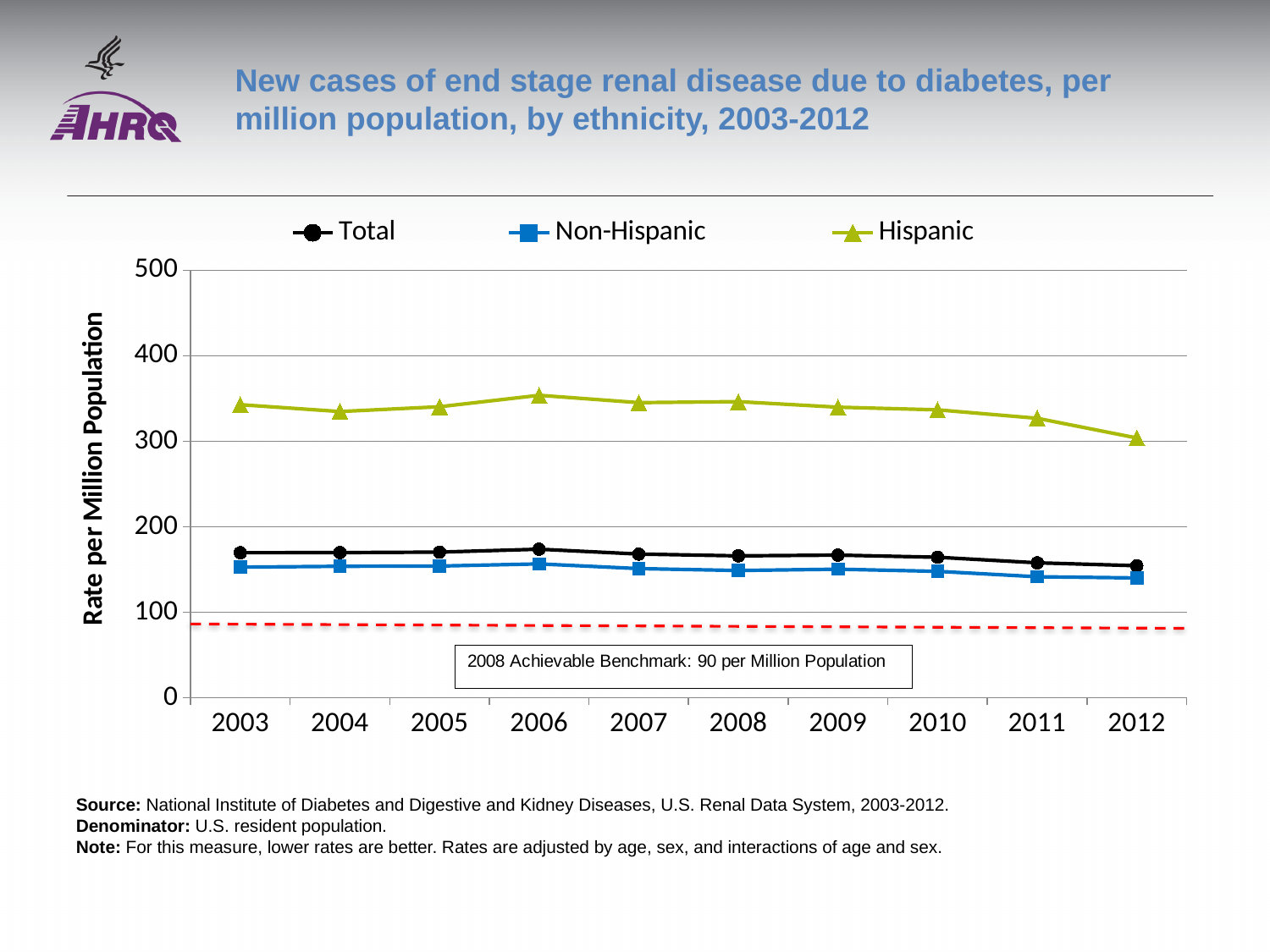
How many years are plotted along the x axis? 10 How many series does the legend list? 3 Is the value for Hispanic in 2006 greater or less than 300? greater In which year is the Hispanic rate lowest? 2012 Which series has the highest rate in 2008? Hispanic Does the Hispanic rate rise or fall from 2010 to 2012? fall Is the value for Non-Hispanic in 2012 greater or less than 100? greater Is the value for Total in 2003 greater or less than 200? less What is the 2008 achievable benchmark shown on the chart? 90 per Million Population What kind of chart is shown on the slide? line chart Which is larger in 2012, the Hispanic rate or the Total rate? Hispanic Which series has the lowest rate in 2012? Non-Hispanic